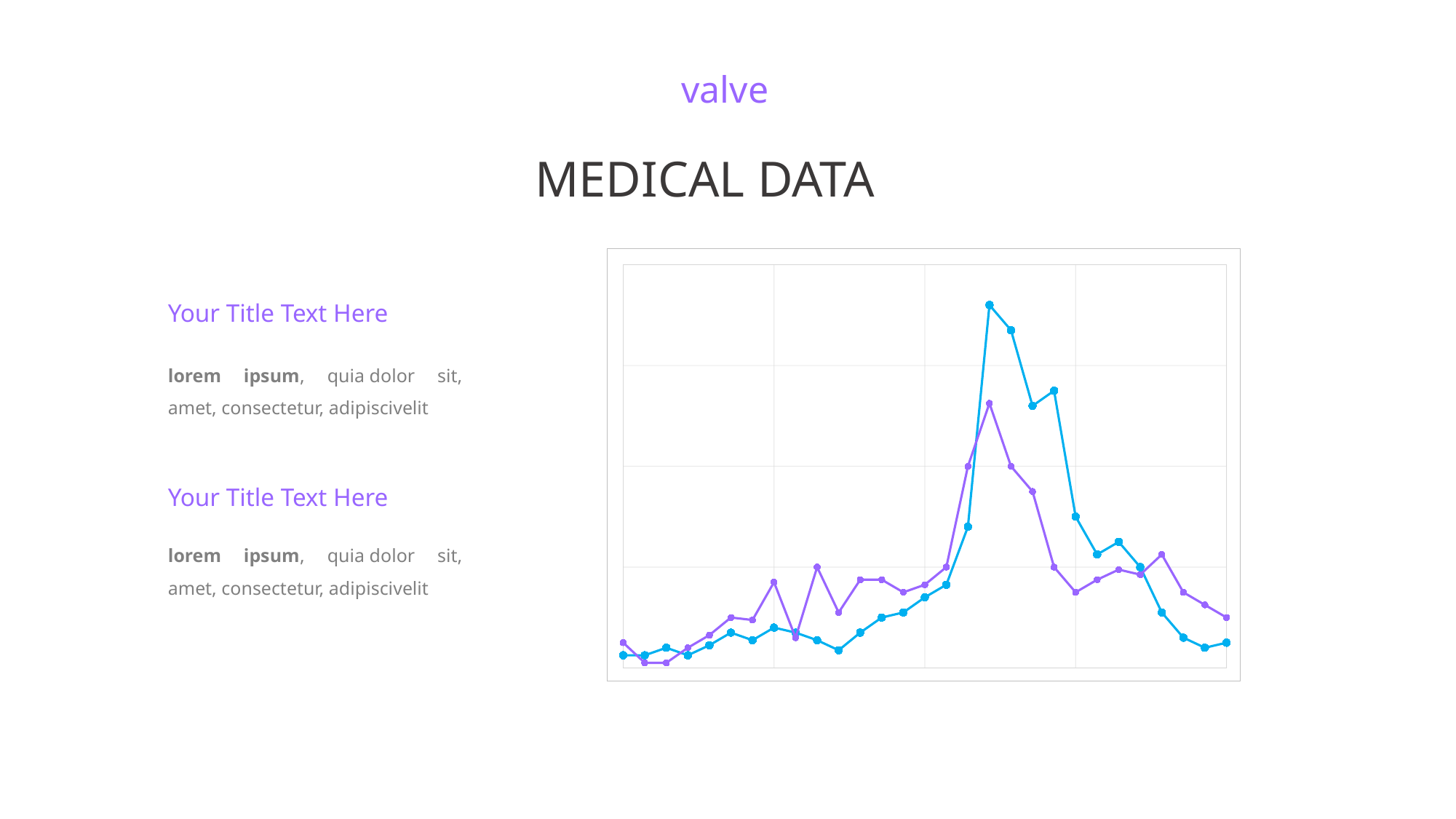
How many lines are plotted on the chart? 2 What colours are the two lines on the chart? blue and purple What kind of chart is shown on the slide? line chart Does the chart display a legend? No Which line reaches the highest peak on the chart, the blue line or the purple line? blue line